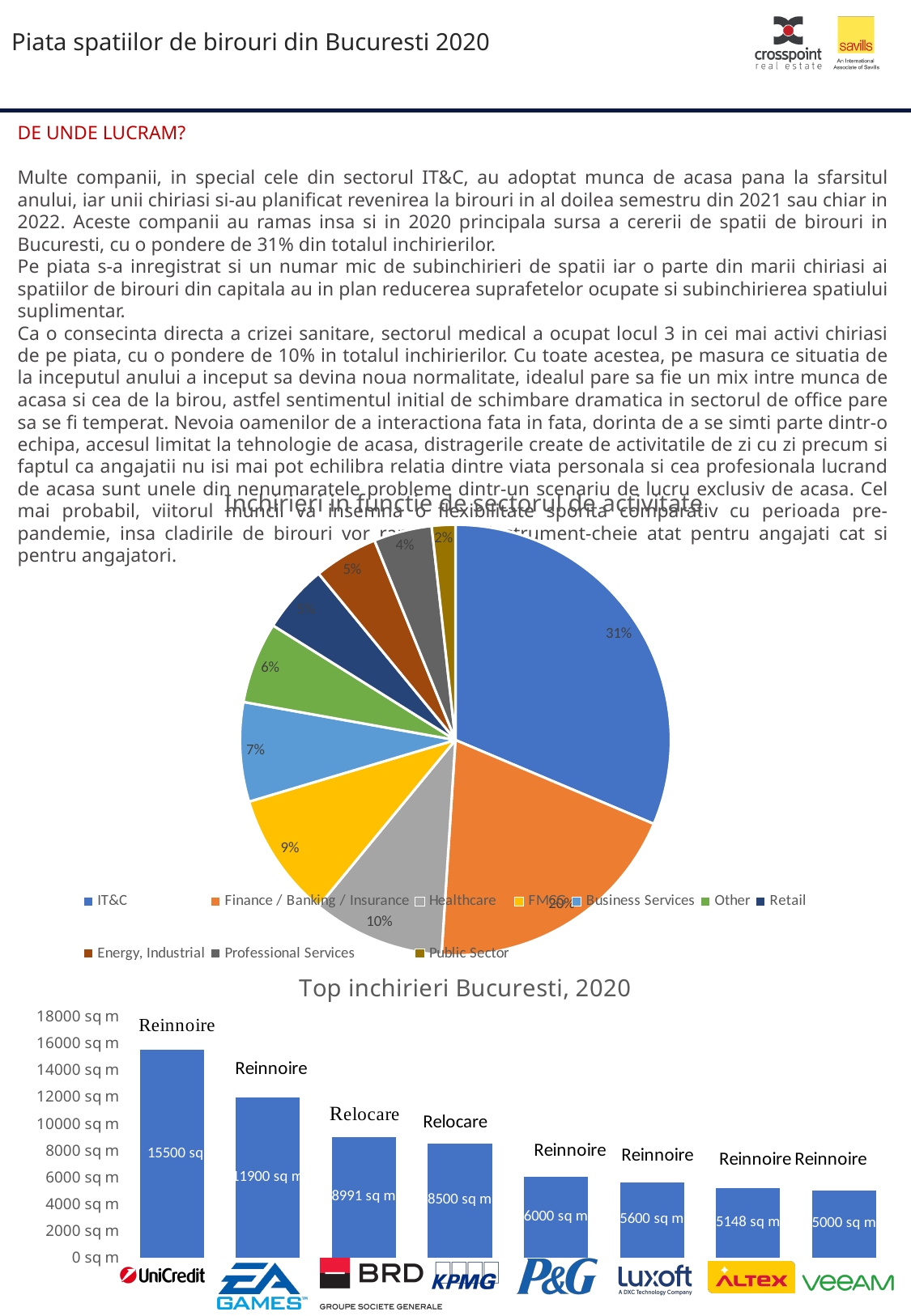
In the pie chart 'Inchirieri in functie de sectorul de activitate', which sector has the largest slice? IT&C In the pie chart 'Inchirieri in functie de sectorul de activitate', what share does Healthcare hold? 10% In the chart 'Top inchirieri Bucuresti, 2020', how many companies are shown? 8 In the chart 'Top inchirieri Bucuresti, 2020', do the values rise or fall from left to right? fall In the pie chart 'Inchirieri in functie de sectorul de activitate', what share does IT&C hold? 31% In the chart 'Top inchirieri Bucuresti, 2020', what is the value for BRD? 8991 sq m What kind of chart is 'Top inchirieri Bucuresti, 2020'? bar chart In the chart 'Top inchirieri Bucuresti, 2020', what is the difference between the UniCredit and EA Games values? 3600 sq m How many sectors does the legend of the pie chart 'Inchirieri in functie de sectorul de activitate' list? 10 In the chart 'Top inchirieri Bucuresti, 2020', what is the value for UniCredit? 15500 sq m In the pie chart 'Inchirieri in functie de sectorul de activitate', which sector has the smallest slice? Public Sector In the pie chart 'Inchirieri in functie de sectorul de activitate', which is larger: the FMCG slice or the Business Services slice? FMCG